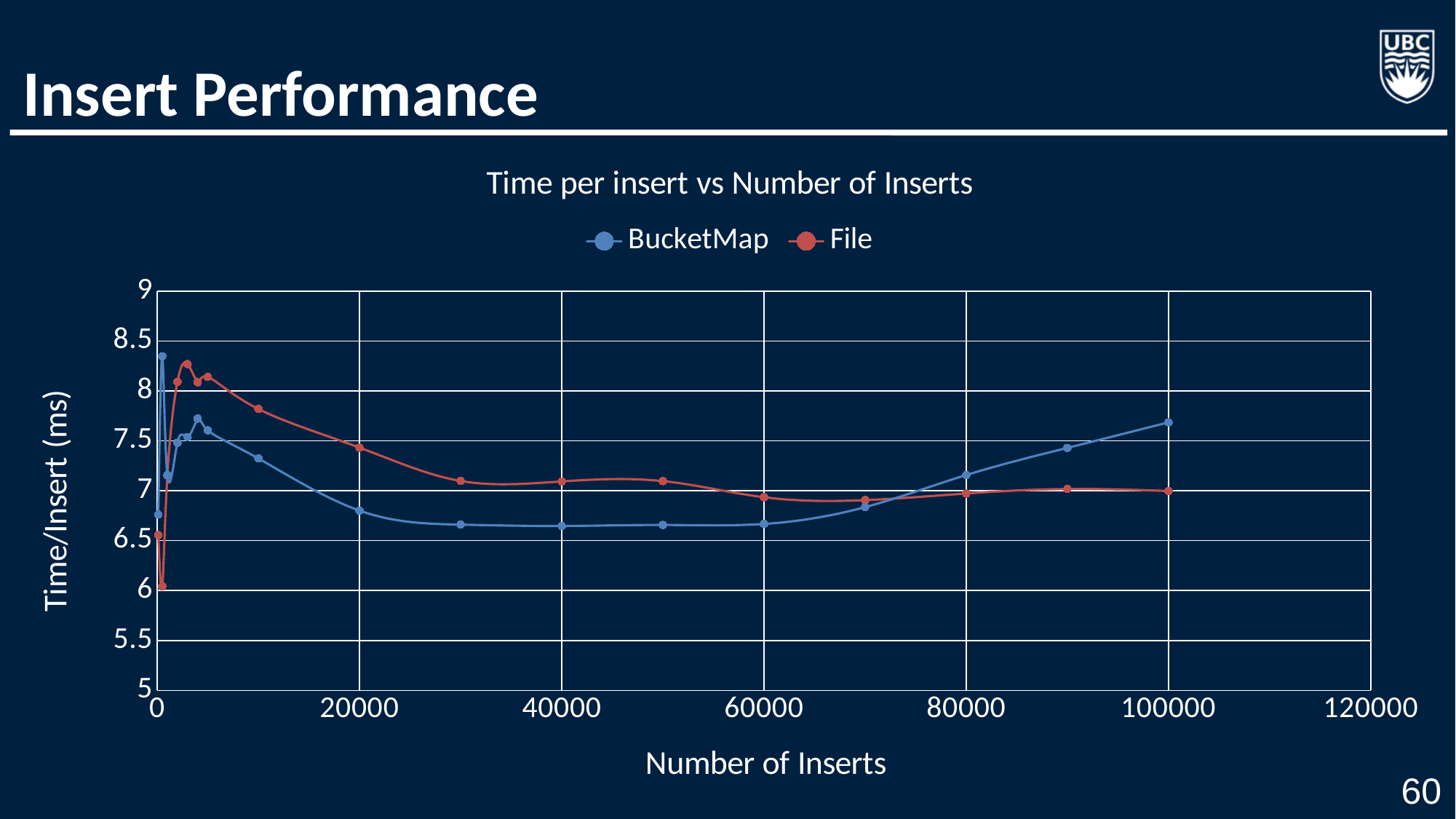
How many series does the legend list? 2 Is the File value at 20000 inserts greater or less than 7? greater Is the BucketMap value at 20000 inserts greater or less than 7? less What is the label of the y axis? Time/Insert (ms) Does the BucketMap series rise or fall between 60000 and 100000 inserts? rise What is the title of the chart? Time per insert vs Number of Inserts What kind of chart is shown on the slide? line chart Is the File value at 10000 inserts greater or less than 7.5? greater At 100000 inserts, which series has the higher time per insert, BucketMap or File? BucketMap At 20000 inserts, which series has the higher time per insert, BucketMap or File? File